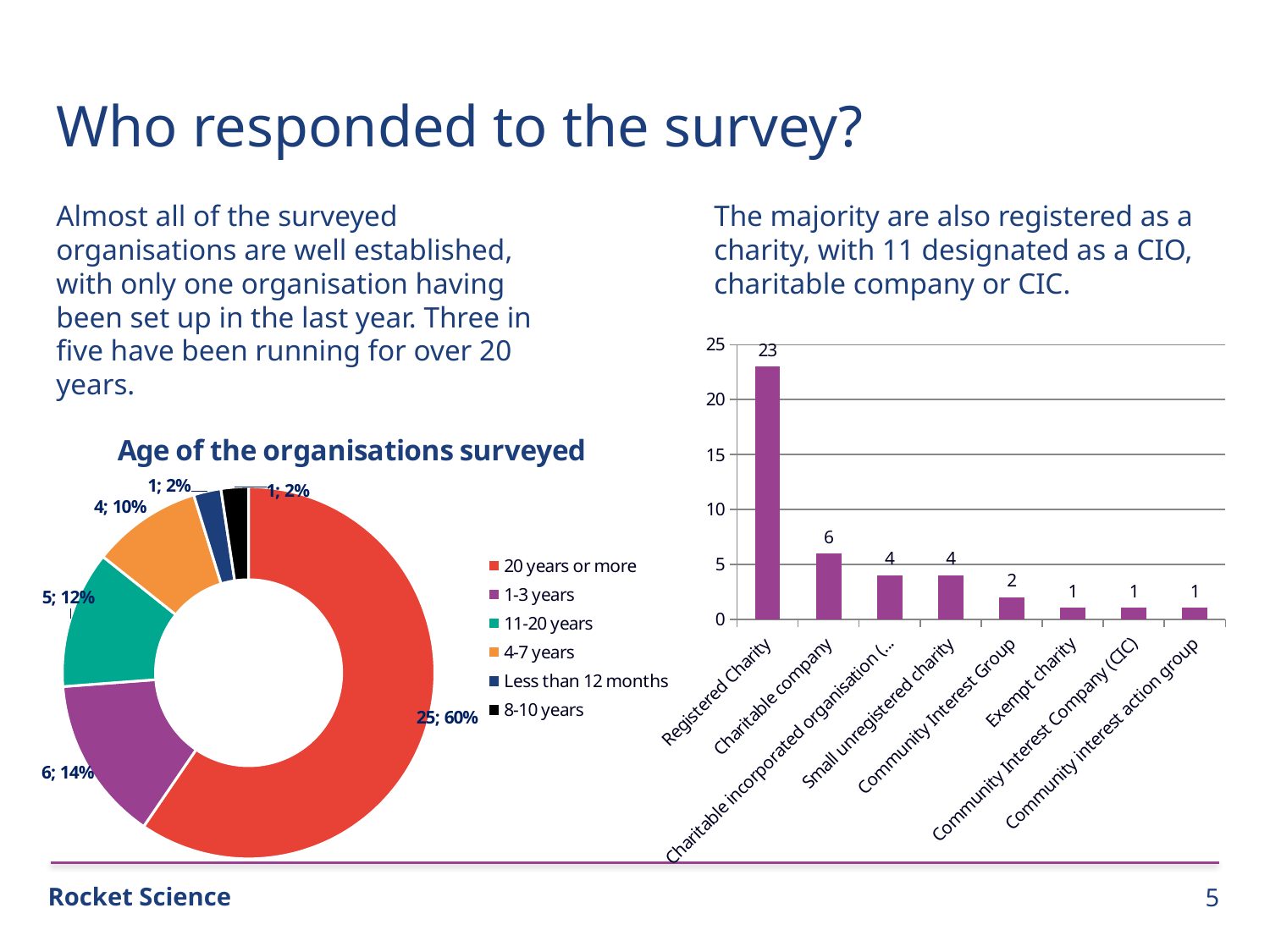
In the bar chart on the right, which category has the highest value? Registered Charity What kind of chart is the 'Age of the organisations surveyed' chart? Doughnut chart In the bar chart on the right, what is the value for Charitable company? 6 In the bar chart on the right, what is the value for Registered Charity? 23 In the 'Age of the organisations surveyed' chart, what percentage of organisations are 11-20 years old? 12% In the bar chart on the right, what is the difference between the values for Registered Charity and Charitable company? 17 In the 'Age of the organisations surveyed' chart, how many organisations are in the 1-3 years category? 6 How many categories does the legend of the 'Age of the organisations surveyed' chart list? 6 In the 'Age of the organisations surveyed' chart, what share of organisations have been running for 20 years or more? 60% In the bar chart on the right, which is larger: the value for Community Interest Group or the value for Exempt charity? Community Interest Group In the 'Age of the organisations surveyed' chart, which age category has the largest share? 20 years or more How many categories are shown in the bar chart on the right? 8